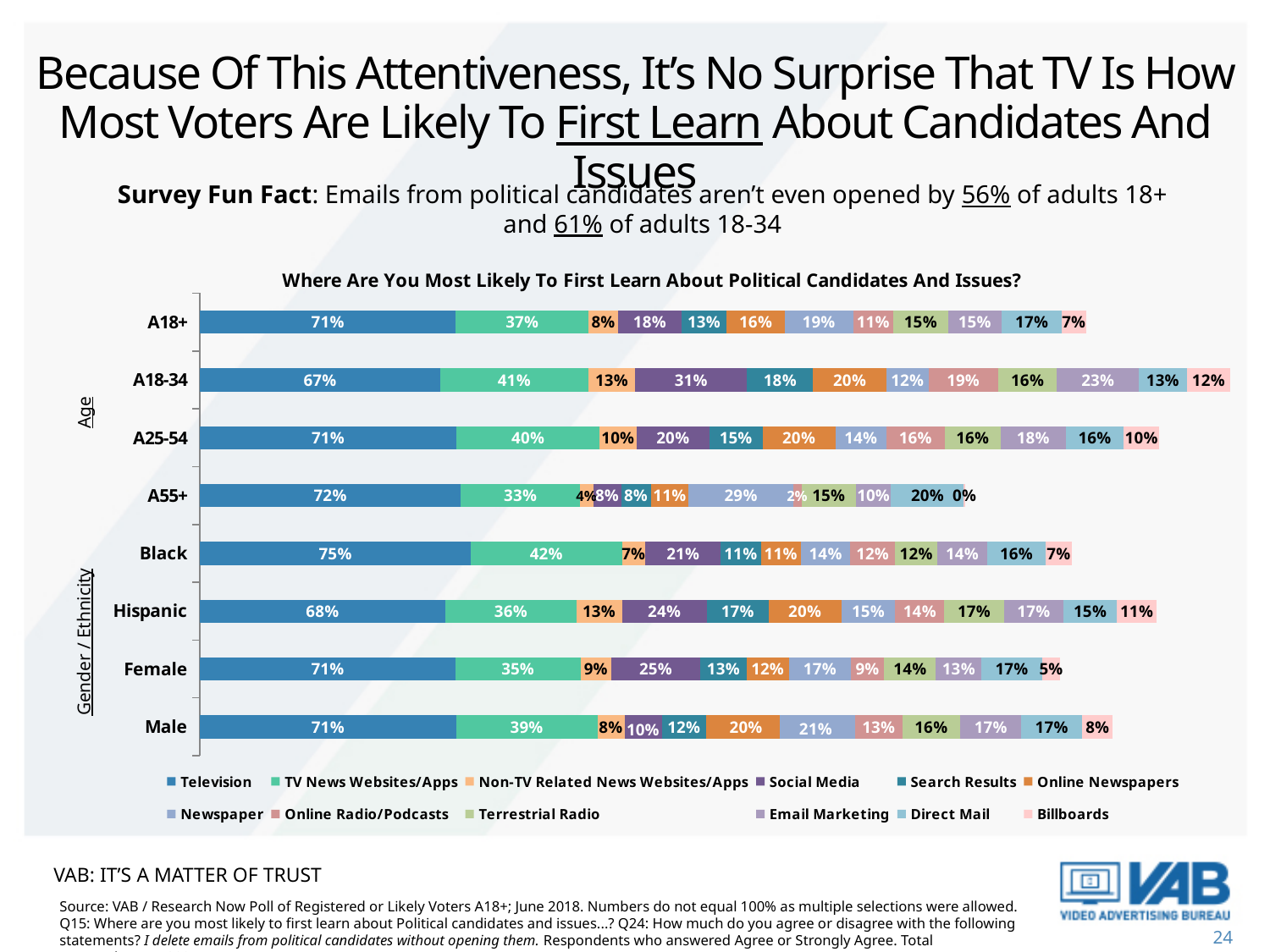
What is the Newspaper value for A55+? 29% Which group has the lowest Television value? A18-34 Which is larger, the TV News Websites/Apps value for Black or for Female? Black What is the difference between the Television values for Black and A18-34? 8 percentage points How many categories (groups) are plotted on the chart? 8 What type of chart is shown on the slide? Stacked bar chart What is the Billboards value for A55+? 0% What is the title of the chart? Where Are You Most Likely To First Learn About Political Candidates And Issues? What is the Social Media value for A18-34? 31% How many series does the legend list? 12 What is the Television value for A18+? 71% Which group has the highest Television value? Black